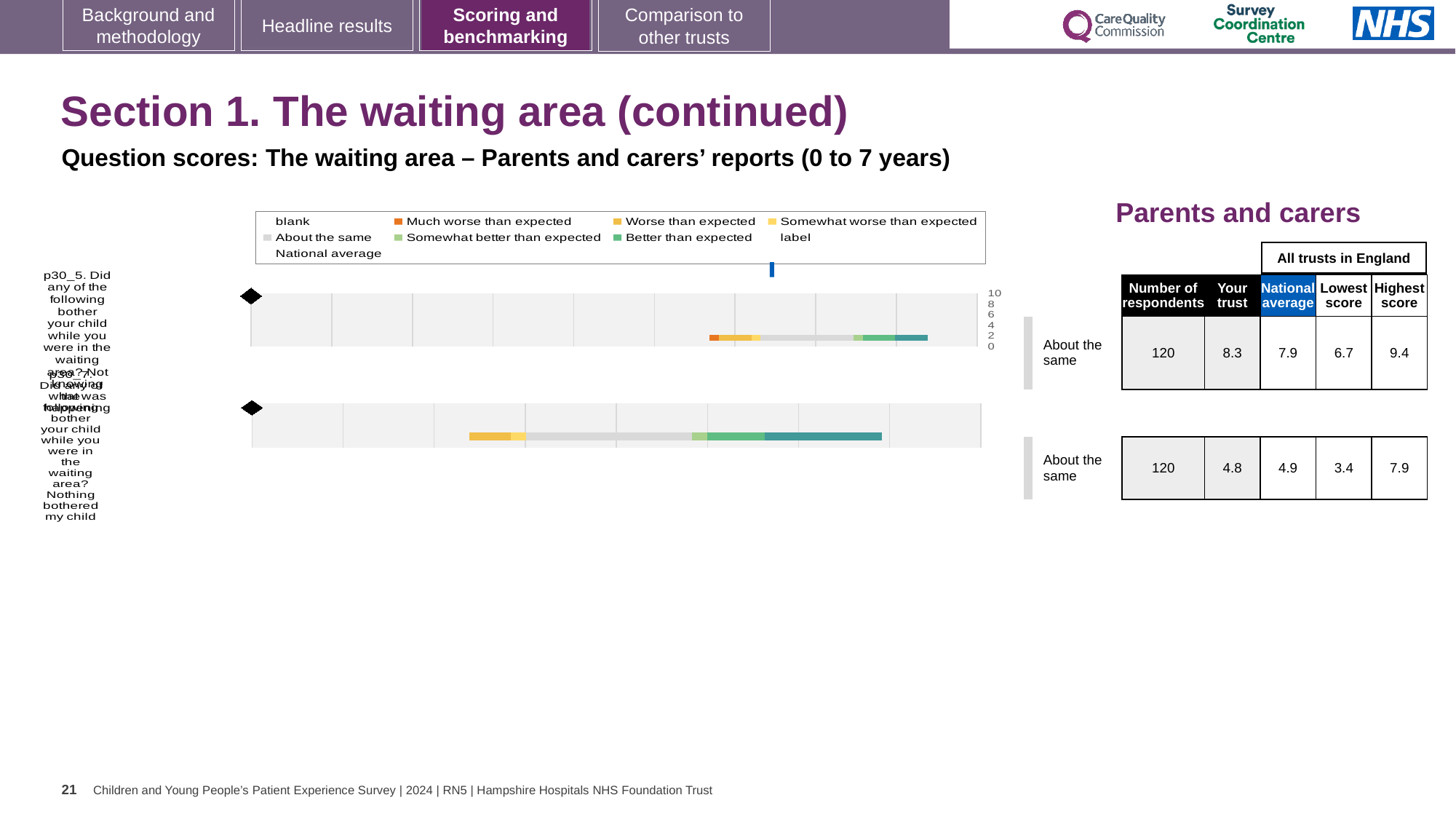
For question p30_7, which is larger: the 'Your trust' score or the national average? National average In the table, what is the national average for question p30_7 (Nothing bothered my child)? 4.9 Which legend entry is shown in orange? Much worse than expected How many bar charts are shown on the slide? 2 What kind of chart is used to show the question scores on this slide? bar chart In the table, what is the highest score across all trusts in England for question p30_7? 7.9 In the table, what is the 'Your trust' score for question p30_5 (Did any of the following bother your child while you were in the waiting area? Not knowing what was happening)? 8.3 What is the highest value shown on the chart's horizontal axis? 10 What is the difference between the highest and lowest scores across all trusts in England for question p30_7? 4.5 What is the difference between the 'Your trust' score and the national average for question p30_5? 0.4 In the table, what is the lowest score across all trusts in England for question p30_5? 6.7 How many respondents answered question p30_5? 120